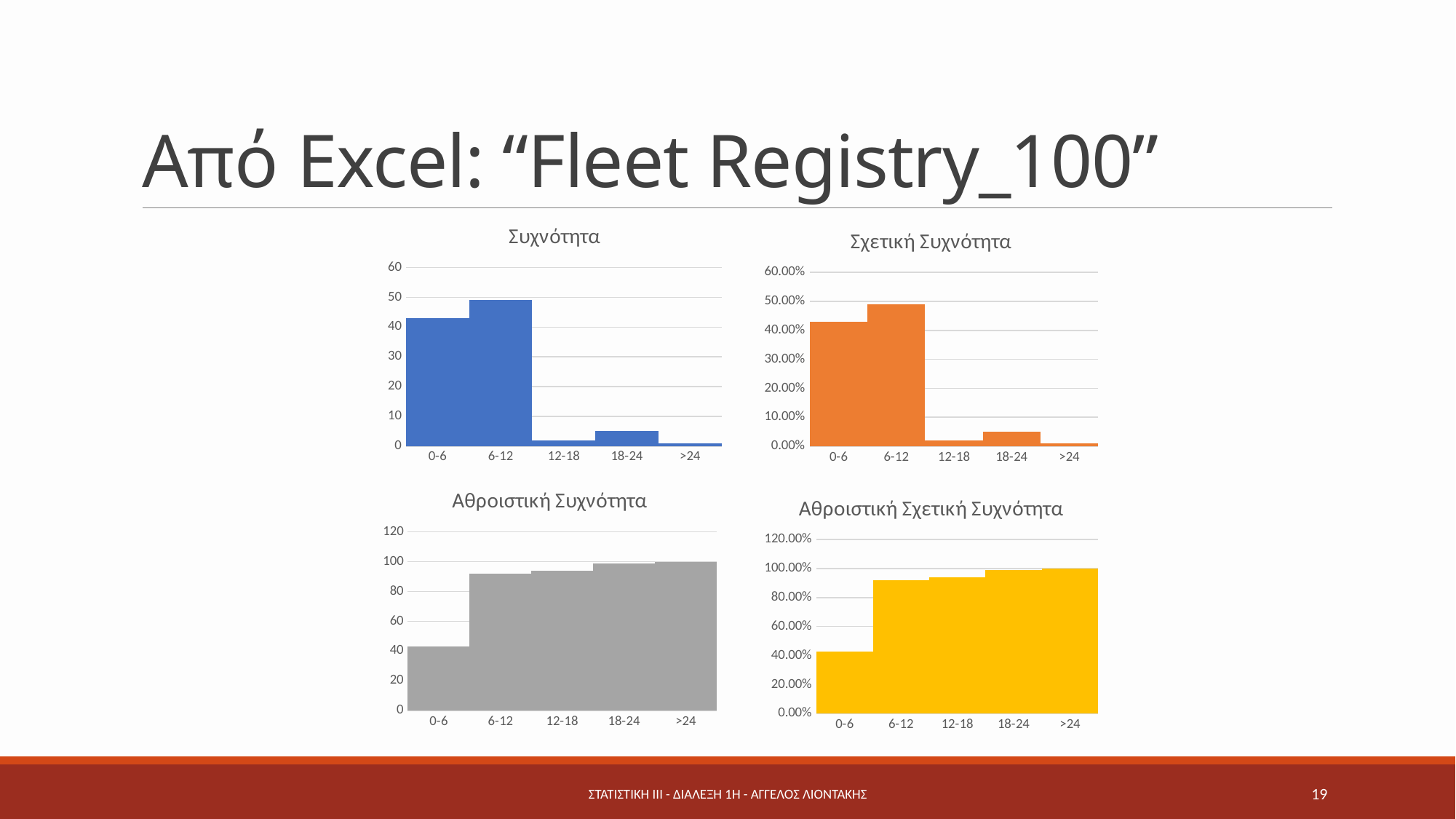
In the "Αθροιστική Συχνότητα" chart, do the values rise or fall from 0-6 to >24? rise In the "Συχνότητα" chart, which is larger, the value for 12-18 or the value for 18-24? 18-24 What kind of chart is the "Συχνότητα" chart? bar chart In the "Αθροιστική Συχνότητα" chart, is the value for 0-6 greater or less than 60? less What colour are the bars in the "Σχετική Συχνότητα" chart? orange How many categories are shown on the x axis of the "Συχνότητα" chart? 5 In the "Συχνότητα" chart, is the value for 0-6 greater or less than 40? greater In the "Αθροιστική Σχετική Συχνότητα" chart, is the value for 6-12 greater or less than 80.00%? greater In the "Συχνότητα" chart, which category has the highest value? 6-12 What is the title of the bottom-right chart? Αθροιστική Σχετική Συχνότητα In the "Σχετική Συχνότητα" chart, which category has the lowest value? >24